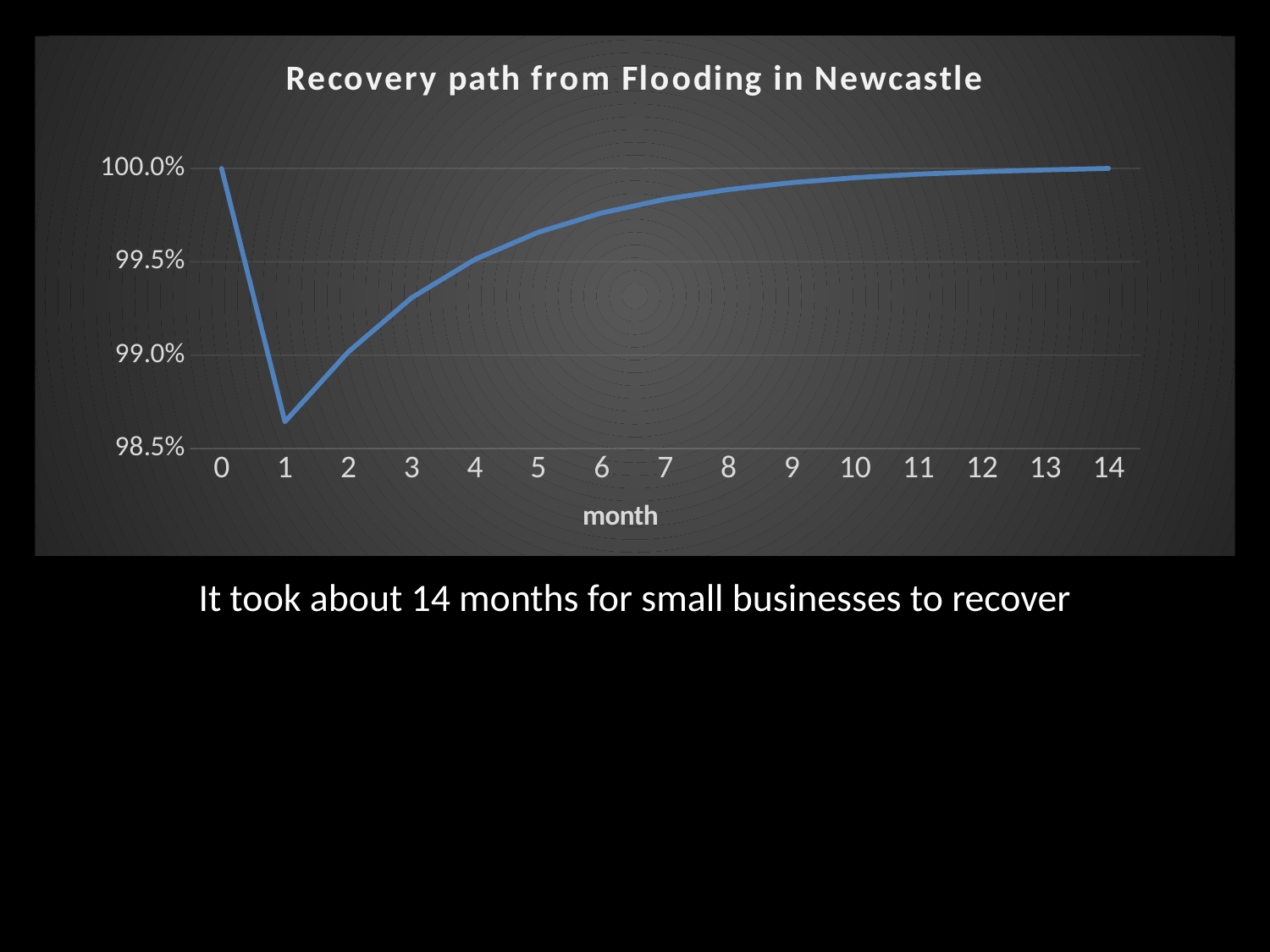
Is the value at month 8 greater or less than 99.5%? greater What is the value at month 0? 100.0% What is the title of the chart? Recovery path from Flooding in Newcastle What kind of chart is shown on the slide? line chart How many months are plotted along the x axis? 15 Is the value at month 1 greater or less than 99.0%? less Which is larger, the value at month 1 or the value at month 5? month 5 Is the value at month 2 greater or less than 99.5%? less From month 1 to month 14, do the values rise or fall? rise What is the label of the x axis? month At which month is the value lowest? 1